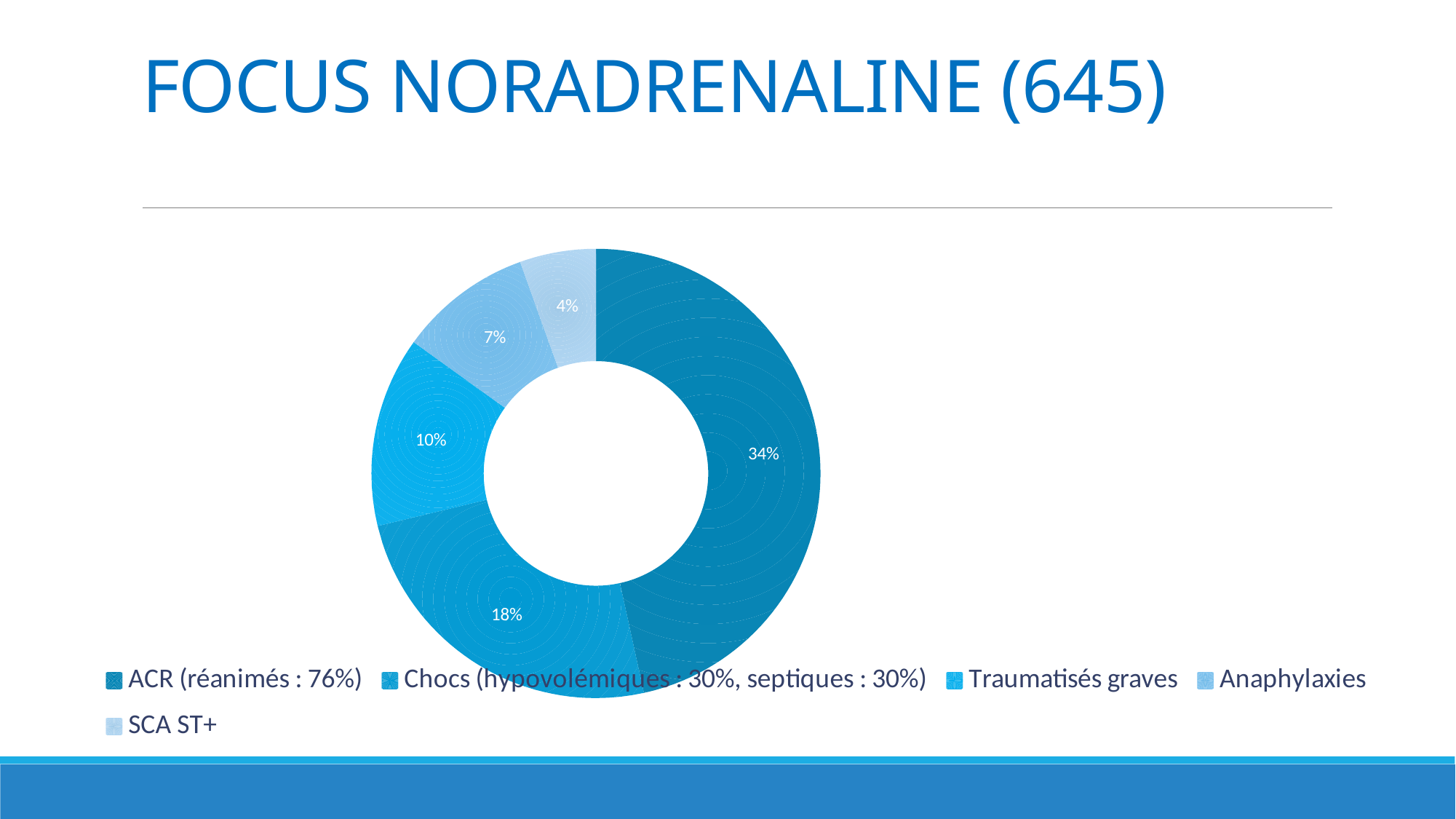
What kind of chart is shown on the slide? Doughnut (pie) chart What percentage is shown for the Traumatisés graves slice? 10% What percentage is shown for the Chocs (hypovolémiques : 30%, septiques : 30%) slice? 18% How many categories does the legend list? 5 What percentage is shown for the Anaphylaxies slice? 7% Which category has the largest slice? ACR (réanimés : 76%) What percentage is shown for the SCA ST+ slice? 4% Which slice is larger, Traumatisés graves or Anaphylaxies? Traumatisés graves What is the title of the slide containing the chart? FOCUS NORADRENALINE (645) What is the difference in percentage points between the ACR slice and the Chocs slice? 16 What percentage is shown for the ACR (réanimés : 76%) slice? 34% Which category has the smallest slice? SCA ST+